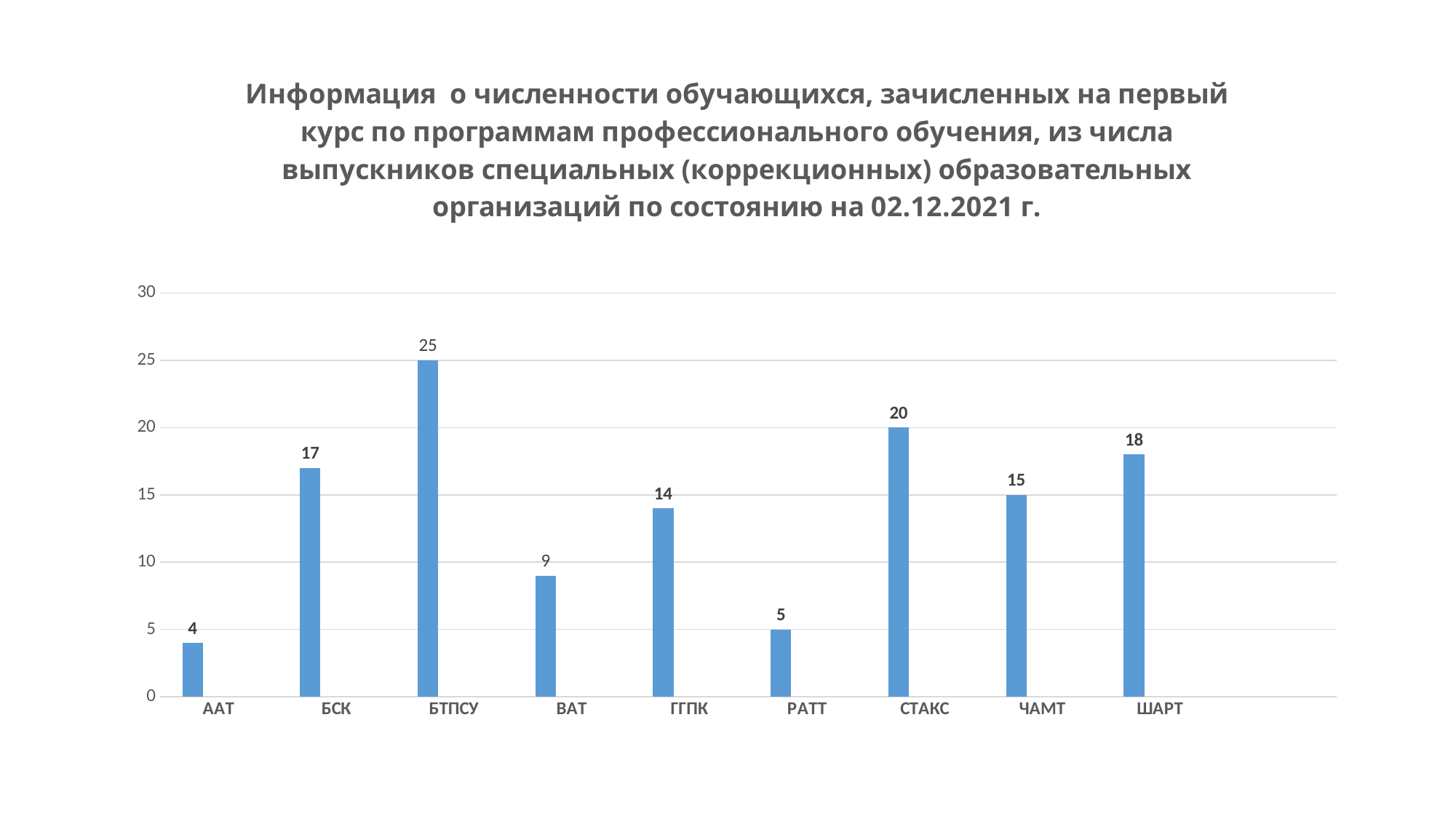
What kind of chart is shown on the slide? bar chart Which is larger, the value for ЧАМТ or the value for ГГПК? ЧАМТ Which category has the highest value? БТПСУ How many categories are shown on the x axis? 9 What is the value for БТПСУ? 25 What is the difference between the values for БСК and ВАТ? 8 Which category has the lowest value? ААТ What is the value for РАТТ? 5 Is the value for ШАРТ greater or less than 15? greater What is the value for СТАКС? 20 What is the difference between the values for БТПСУ and ШАРТ? 7 What is the highest value shown on the vertical axis? 30